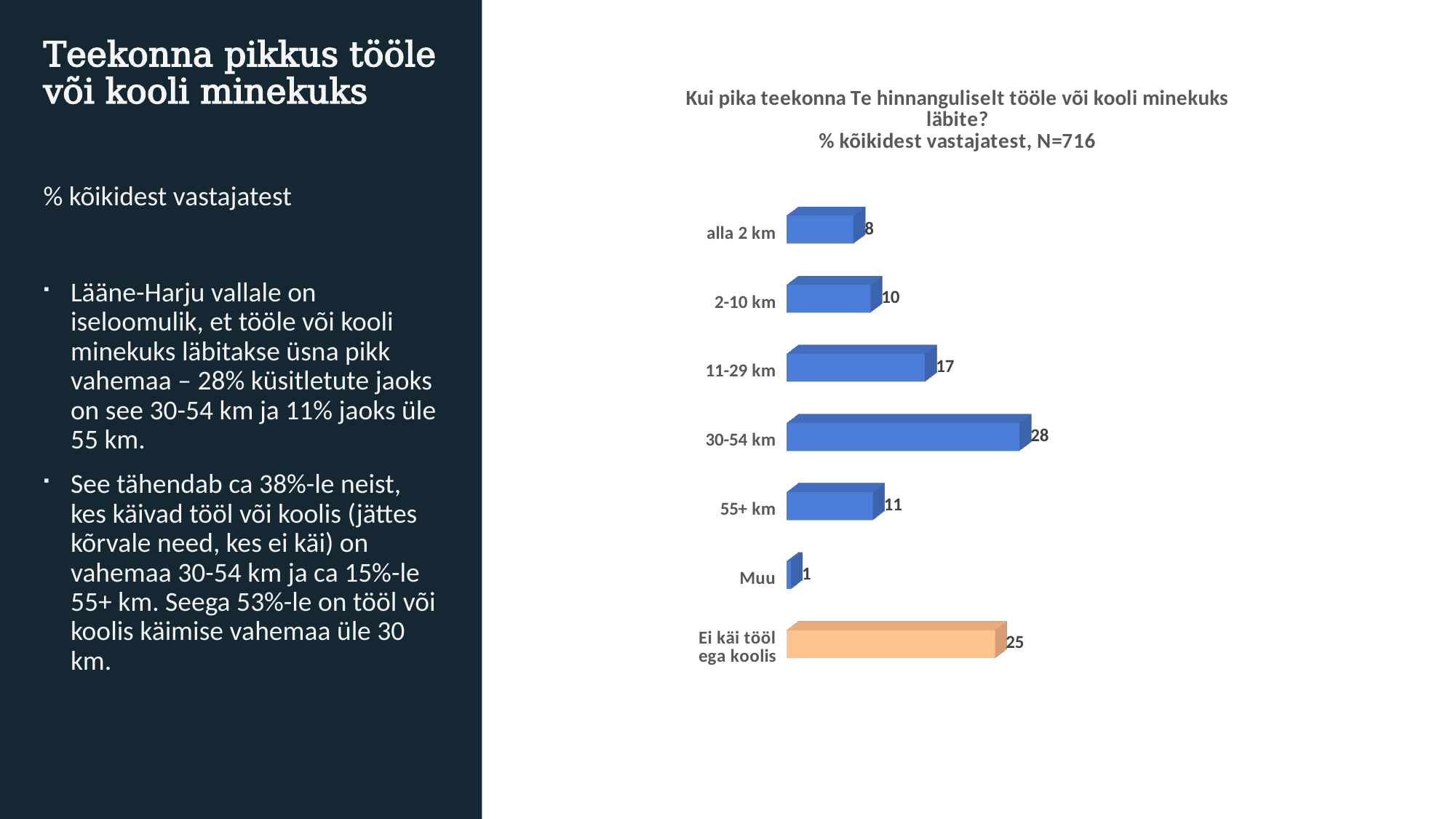
What is the value for the 'alla 2 km' category? 8 What is the difference between the values for '30-54 km' and '11-29 km'? 11 What is the N (number of respondents) stated in the chart title? N=716 What is the value for the 'Ei käi tööl ega koolis' category? 25 What is the value for the '30-54 km' category? 28 What is the value for the '55+ km' category? 11 Which category has the lowest value? Muu Which category has the highest value? 30-54 km What is the total of the values for 'alla 2 km' and '2-10 km'? 18 What kind of chart is shown on the slide? Bar chart How many categories are shown in the chart? 7 Which is larger, the value for '2-10 km' or the value for '55+ km'? 55+ km